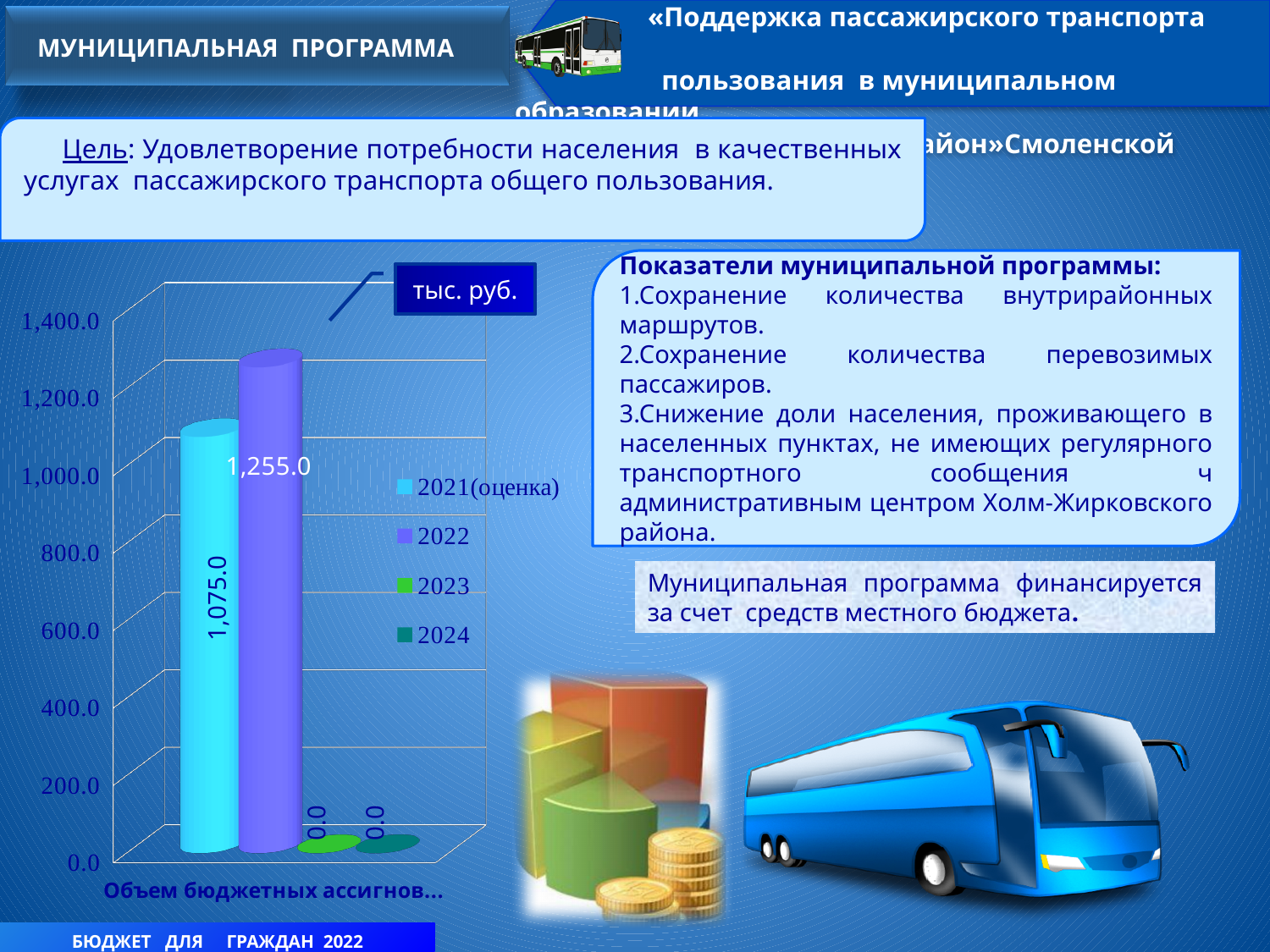
What is the value for 2023 in the chart? 0.0 Which is larger, the value for 2021(оценка) or the value for 2022? 2022 What is the difference between the values for 2022 and 2021(оценка)? 180.0 What is the value for 2024 in the chart? 0.0 What type of chart is shown on the slide? bar chart What is the value for 2021(оценка) in the chart? 1,075.0 What is the value for 2022 in the chart? 1,255.0 Which series has the highest value in the chart? 2022 What is the highest value shown on the chart's vertical axis? 1,400.0 How many series does the chart legend list? 4 Is the value for 2022 greater or less than 1,200.0? greater What unit of measurement is shown in the box above the chart? тыс. руб.